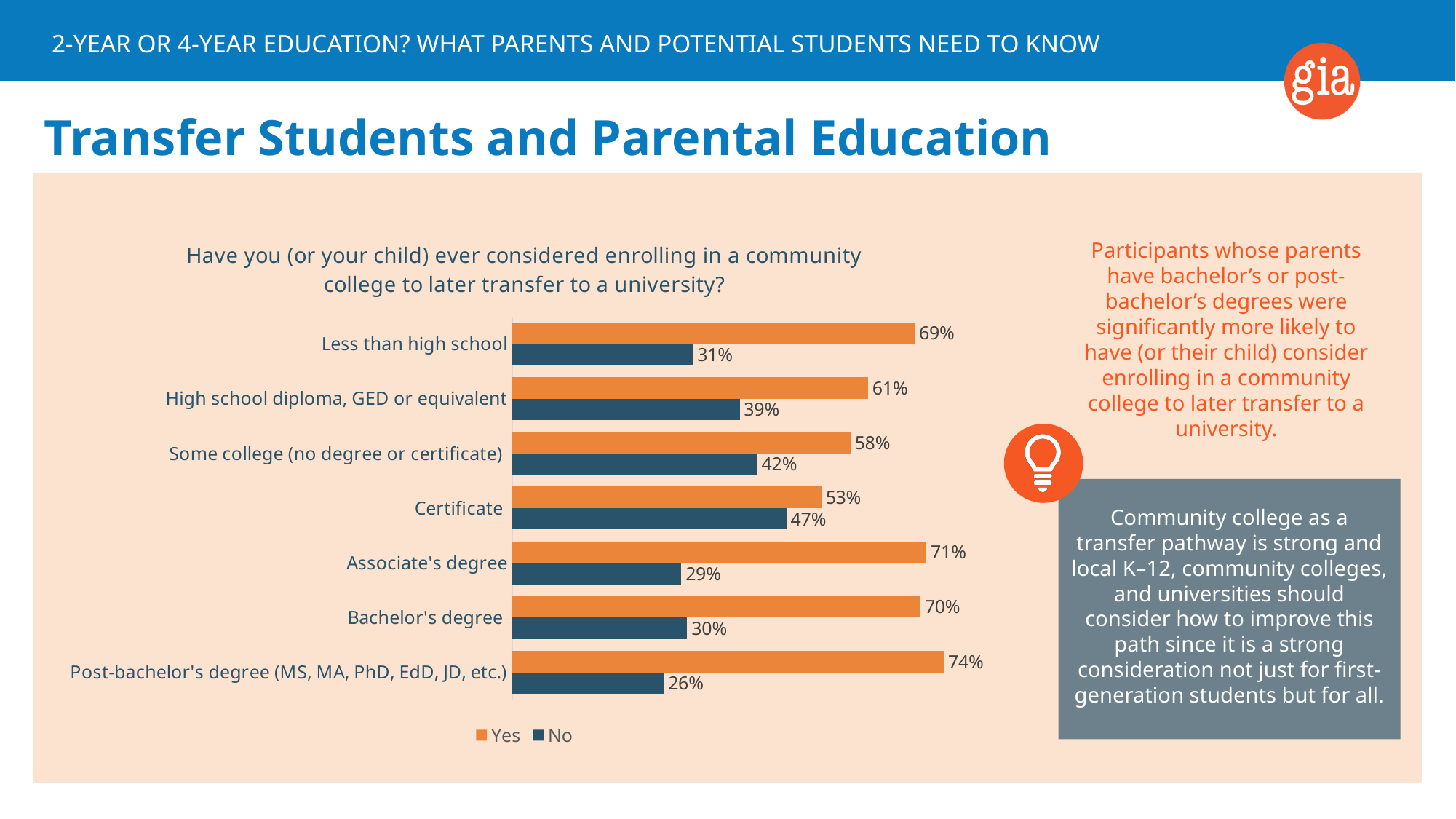
Which is larger: the Yes value for Less than high school or the Yes value for High school diploma, GED or equivalent? Less than high school What is the difference between the Yes and No values for Associate's degree? 42% How many series does the legend list? 2 Which category has the highest Yes value? Post-bachelor's degree (MS, MA, PhD, EdD, JD, etc.) What type of chart is shown on the slide? Bar chart Which category has the lowest Yes value? Certificate What is the No value for the Certificate category? 47% What percentage of participants whose parents have a Post-bachelor's degree answered Yes? 74% What is the Yes value for Some college (no degree or certificate)? 58% Which category has the highest No value? Certificate How many parental education categories are shown in the chart? 7 Which colour represents the Yes series in the chart? Orange